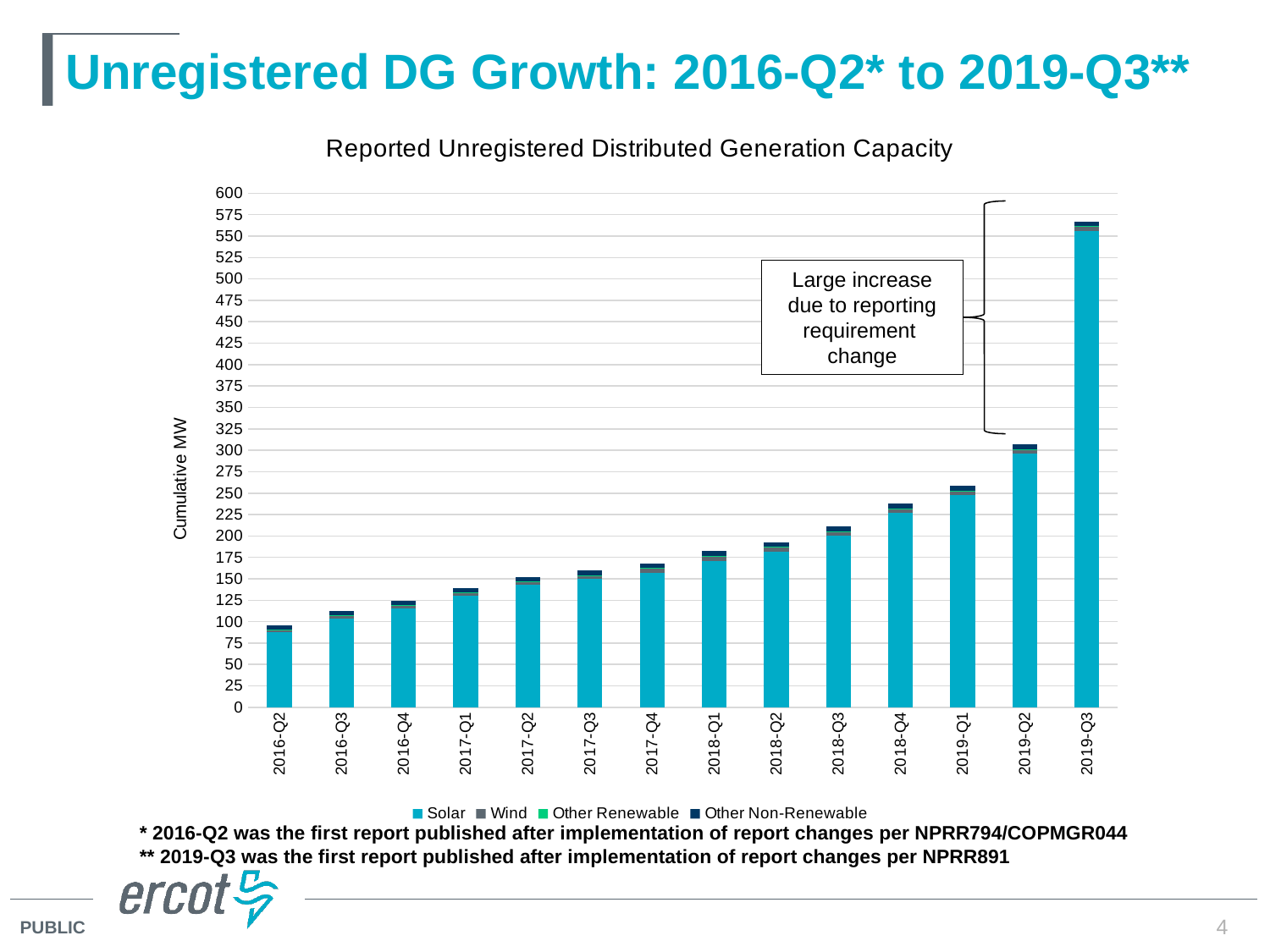
What is the label on the y axis? Cumulative MW What is the title of the chart? Reported Unregistered Distributed Generation Capacity Is the total value for 2019-Q3 greater or less than 550? greater How many series does the legend list? 4 Which quarter has the highest total reported unregistered DG capacity? 2019-Q3 Is the total value for 2018-Q1 greater or less than 200? less Which quarter has a larger total bar, 2017-Q2 or 2018-Q2? 2018-Q2 How many quarters (categories) are plotted along the x axis? 14 Do the total bar heights rise or fall from 2016-Q2 to 2019-Q3? Rise What kind of chart is shown on the slide? Stacked bar chart Which quarter has the lowest total reported unregistered DG capacity? 2016-Q2